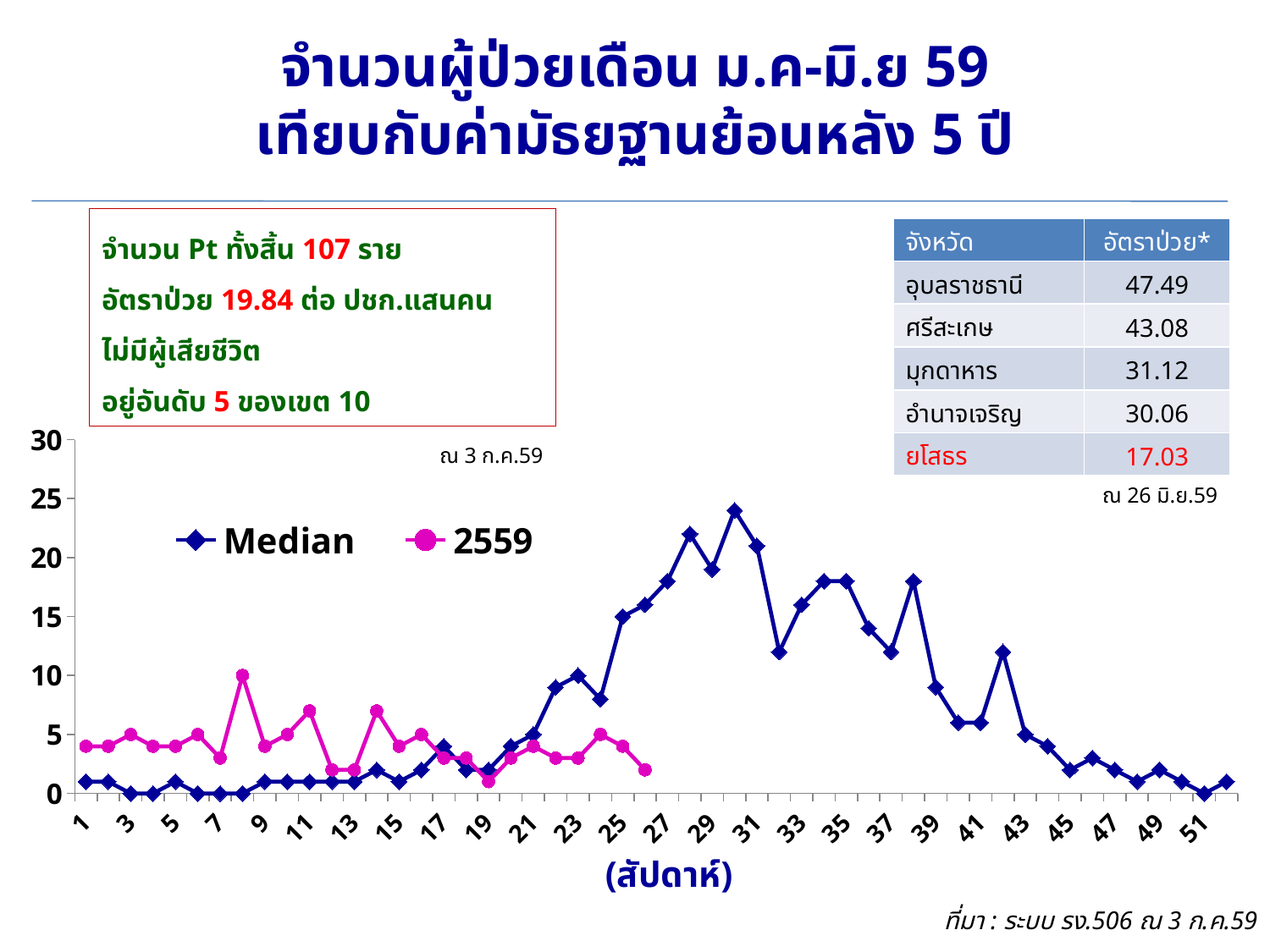
At week 10, which series has the larger value, Median or 2559? 2559 How many series does the chart legend list? 2 What kind of chart is shown on the slide? line chart Is the Median value at week 30 greater or less than 20? greater At which week does the Median series reach its highest value? 30 What is the x-axis label of the chart? (สัปดาห์) Is the Median value at week 1 greater or less than 5? less At which week does the 2559 series reach its highest value? 8 What are the two series named in the chart legend? Median and 2559 Does the Median series rise or fall from week 30 to week 40? fall Is the 2559 value at week 8 greater or less than 5? greater At week 8, which series has the larger value, Median or 2559? 2559